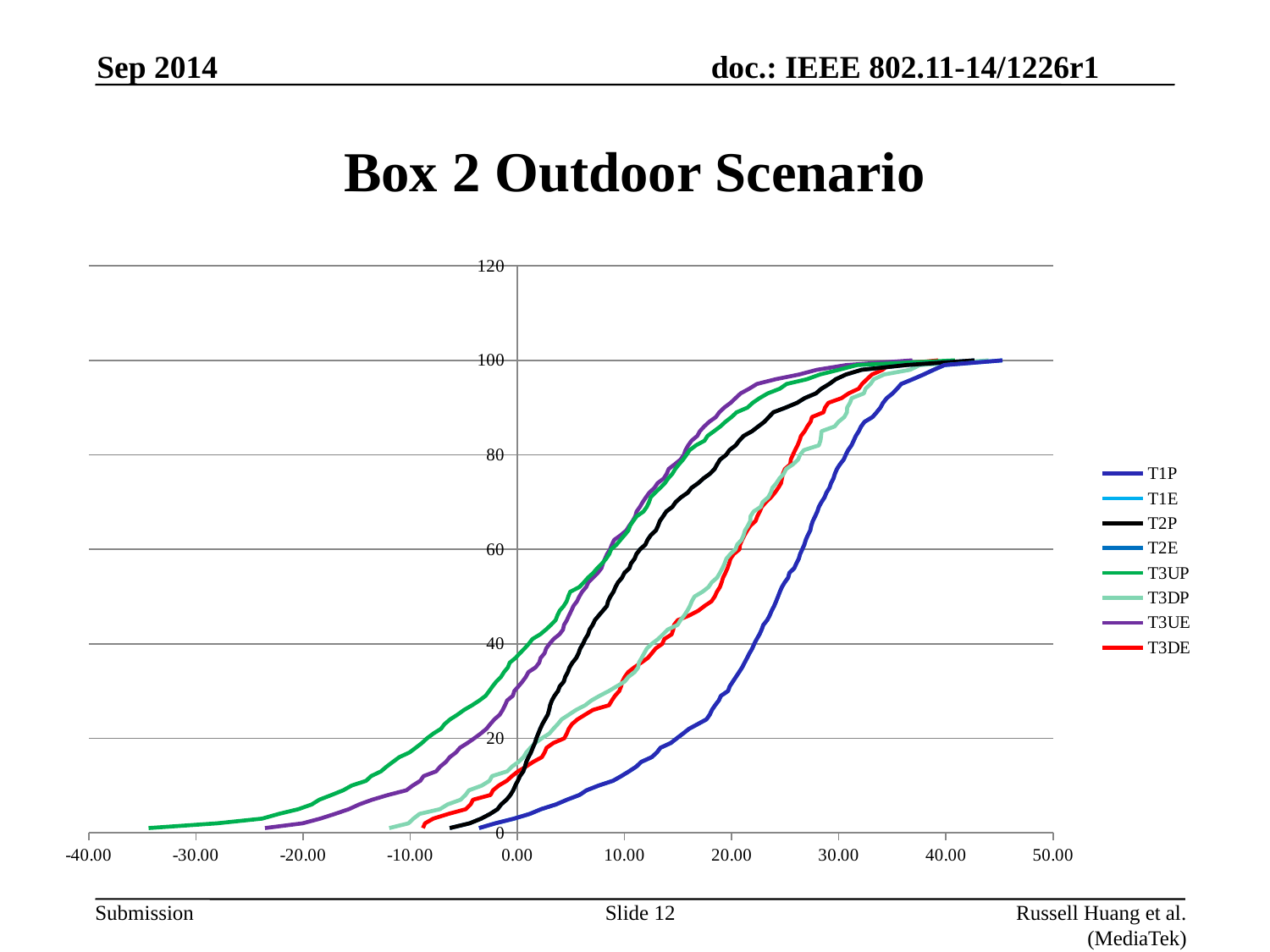
What kind of chart is shown on the slide? line chart Is the value of the T3UP curve at x = 0.00 greater or less than 20? greater How many series does the legend list? 8 Which legend entry is drawn in red? T3DE Is the value of the T1P curve at x = 10.00 greater or less than 20? less At x = 0.00, which curve is higher, T3UP or T1P? T3UP What is the title of the chart? Box 2 Outdoor Scenario Do the curves rise or fall as the x-axis value increases? rise Is the value of the T3UE curve at x = 10.00 greater or less than 40? greater Which curve reaches 100 at the largest x value (furthest to the right)? T1P